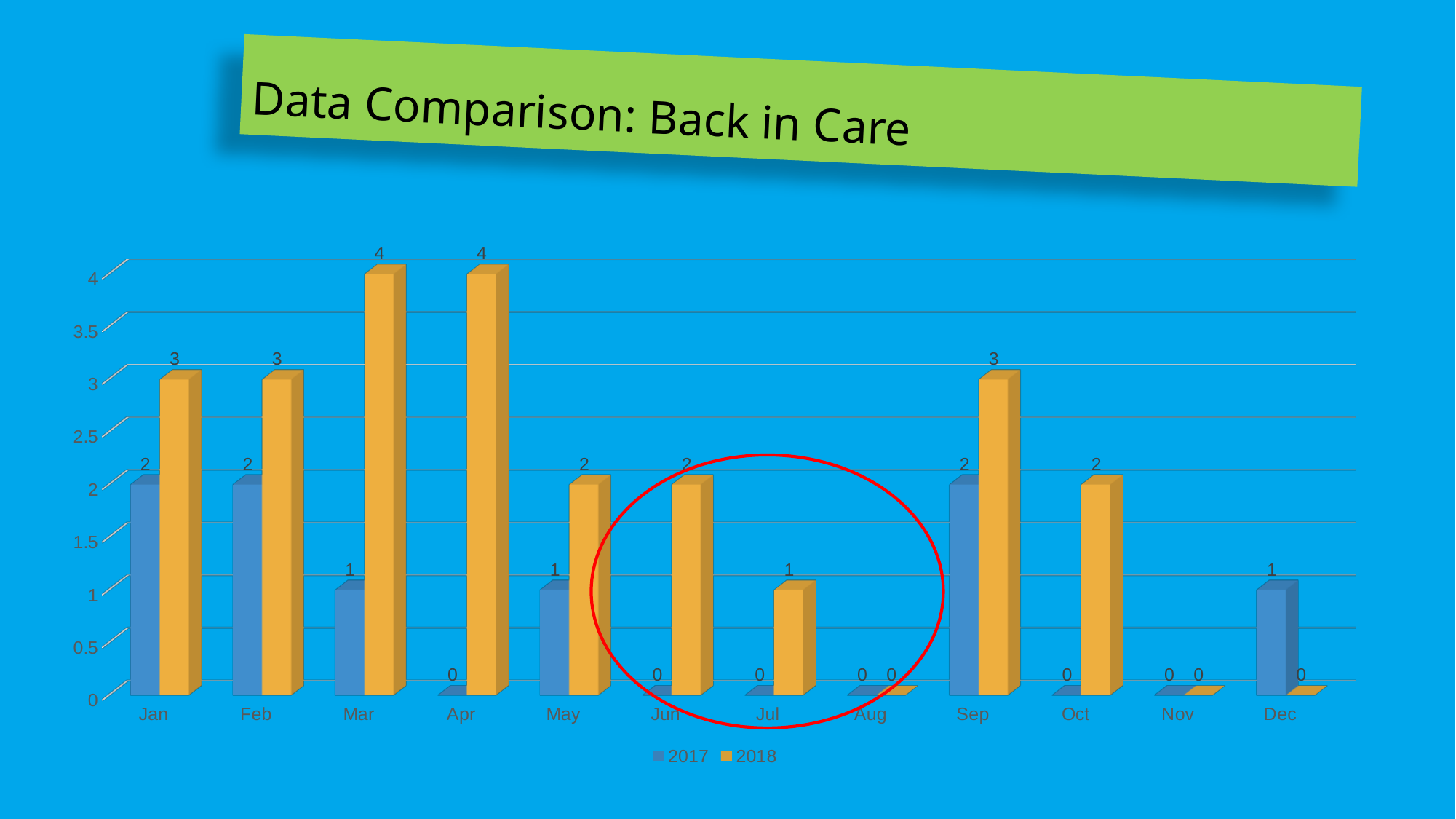
How many months are shown on the x axis? 12 Which is larger, the 2017 value for Mar or the 2017 value for Feb? Feb How many series does the legend list? 2 What is the value for 2017 in Sep? 2 What kind of chart is shown on the slide? Bar chart What is the difference between the 2018 and 2017 values in Apr? 4 What is the value for 2017 in Dec? 1 What is the value for 2018 in Mar? 4 What is the difference between the 2018 values for Jan and May? 1 Which is larger in Oct, the 2017 value or the 2018 value? 2018 What is the value for 2018 in Jul? 1 What is the title of the slide? Data Comparison: Back in Care